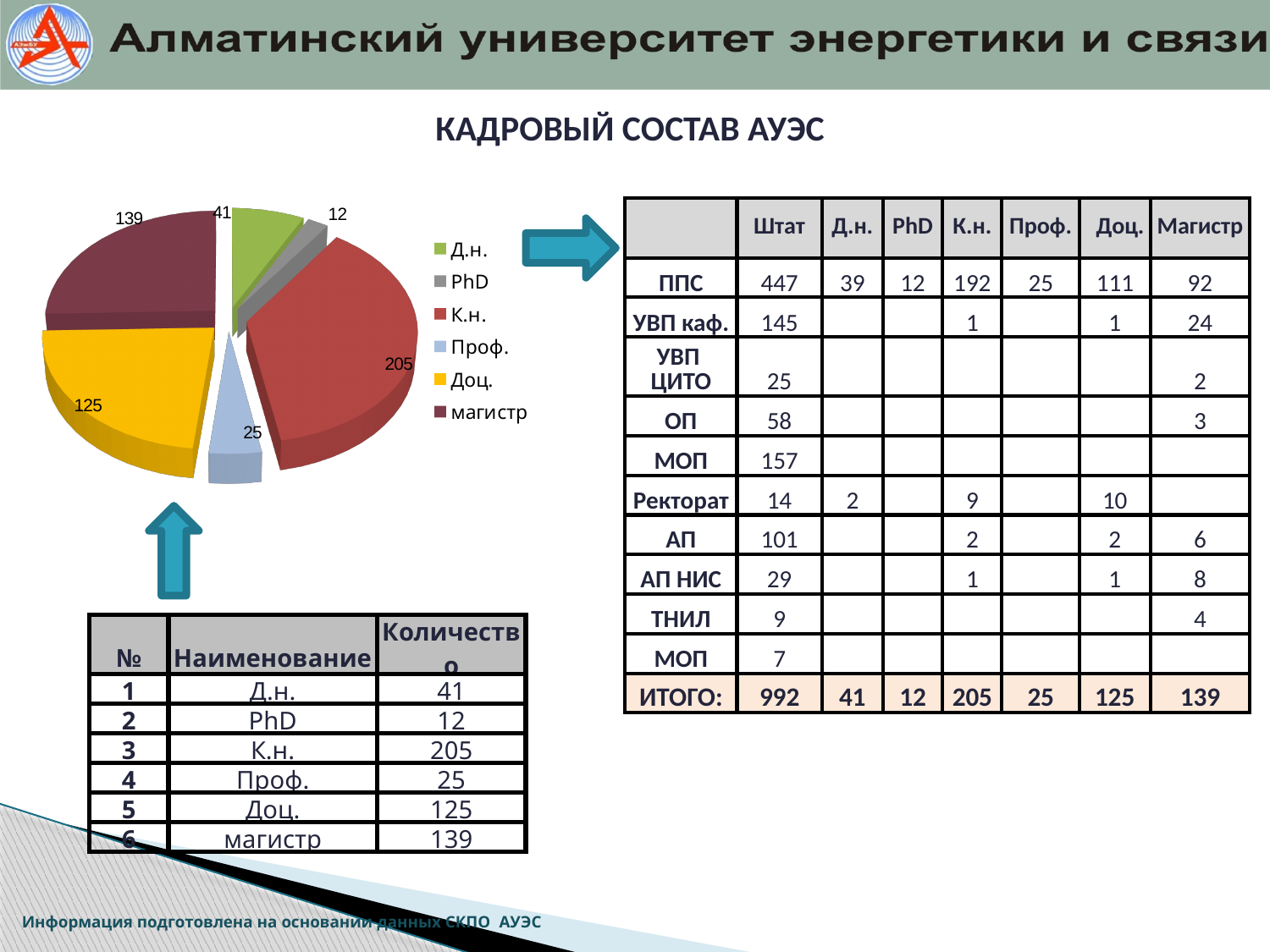
Which colour is used for the Доц. slice in the pie chart? yellow What type of chart is shown on the slide? pie chart What is the difference between the values for К.н. and Доц. in the pie chart? 80 Which category has the smallest slice in the pie chart? PhD What is the difference between the values for Д.н. and Проф. in the pie chart? 16 In the pie chart, what is the value for PhD? 12 In the pie chart, what is the value for Доц.? 125 Which category has the largest slice in the pie chart? К.н. In the pie chart, what is the value for К.н.? 205 In the pie chart, which is larger: магистр or Доц.? магистр In the pie chart, what is the value for магистр? 139 How many slices does the pie chart have? 6